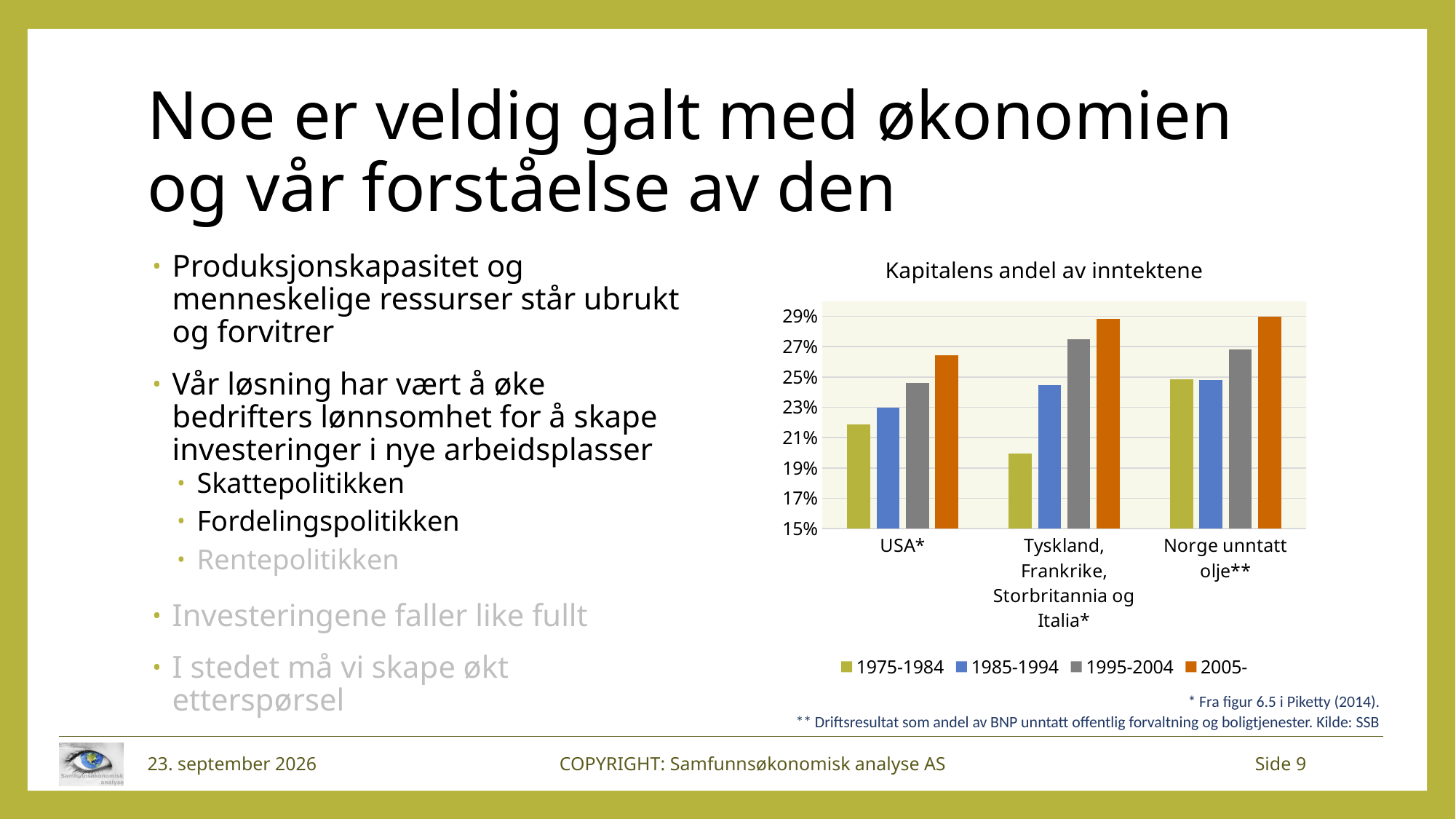
How many series does the chart legend list? 4 Is the value for USA* in 1975-1984 greater or less than 23%? less Which is larger for the 2005- series: USA* or Tyskland, Frankrike, Storbritannia og Italia*? Tyskland, Frankrike, Storbritannia og Italia* Which period has the lowest value for Tyskland, Frankrike, Storbritannia og Italia*? 1975-1984 Is the value for Tyskland, Frankrike, Storbritannia og Italia* in 1975-1984 greater or less than 21%? less Which is larger for the 1975-1984 series: USA* or Norge unntatt olje**? Norge unntatt olje** What kind of chart is shown on the slide? bar chart Which period has the highest value for USA*? 2005- For USA*, do the values rise or fall from 1975-1984 to 2005-? rise What is the title of the chart? Kapitalens andel av inntektene Is the value for Norge unntatt olje** in 2005- greater or less than 27%? greater How many categories are shown on the x axis of the chart? 3